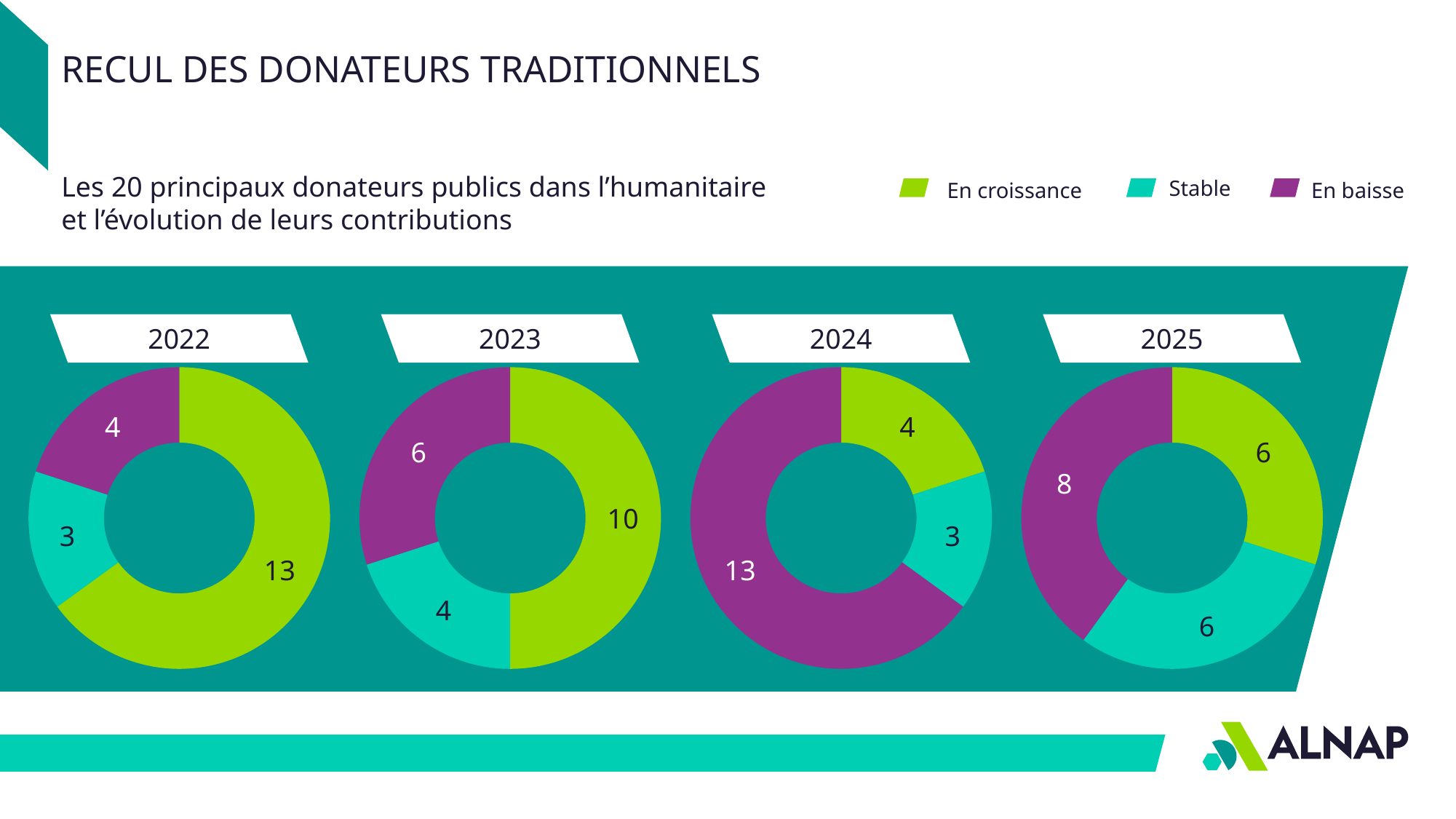
In the 2022 chart, what is the value for En croissance? 13 In the 2024 chart, what is the value for En baisse? 13 In the 2023 chart, which category has the highest value? En croissance How many categories does the legend list? 3 In the 2024 chart, what is the difference between En baisse and En croissance? 9 In the 2023 chart, what share of the total does En croissance represent? 50% In the 2025 chart, what is the value for Stable? 6 In the 2025 chart, which is larger, En baisse or En croissance? En baisse What kind of chart is used for each year on the slide? Donut chart In the 2022 chart, which category has the lowest value? Stable How many donut charts are shown on the slide? 4